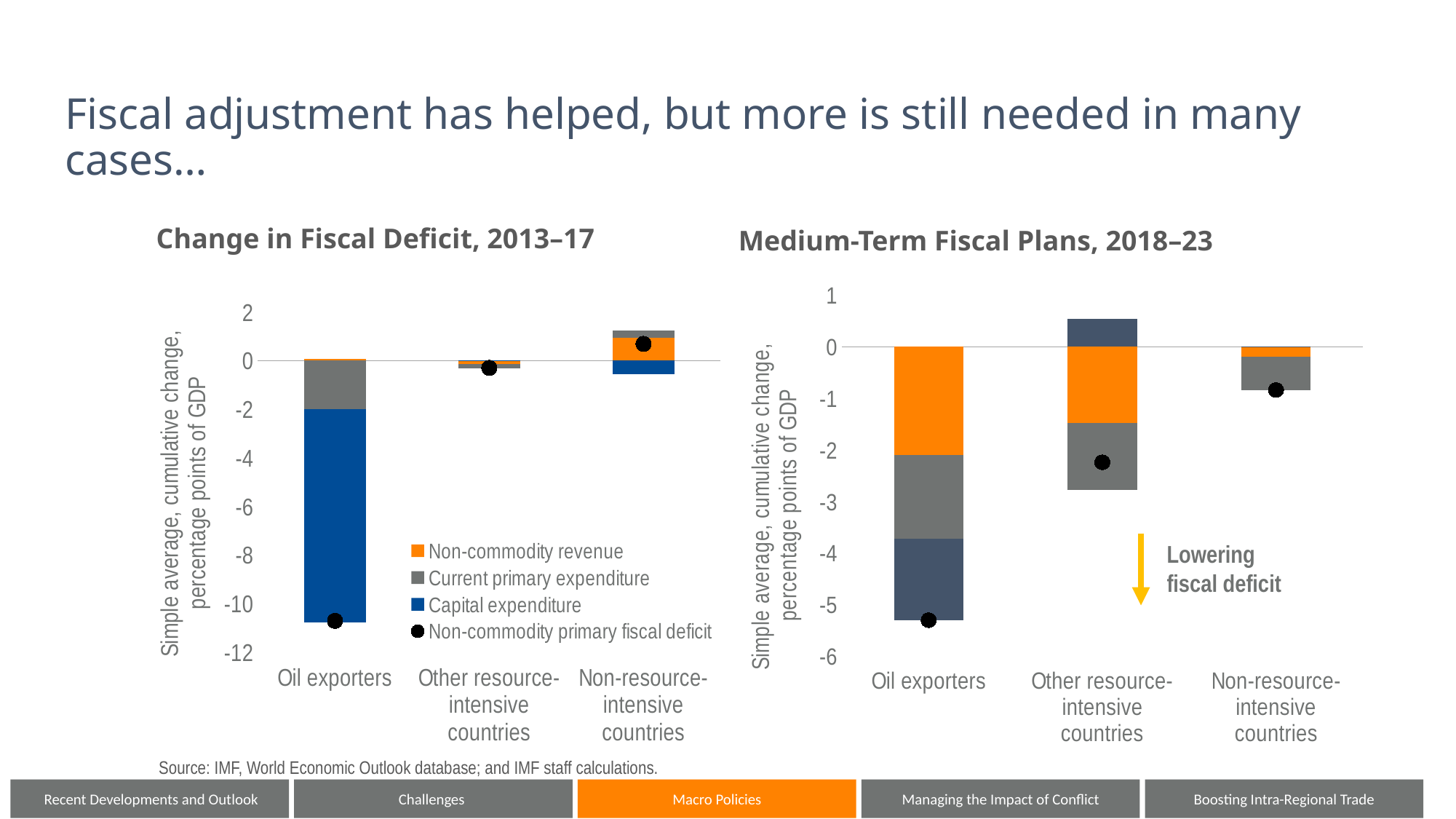
Which legend entry on the 'Change in Fiscal Deficit, 2013–17' chart is shown in orange? Non-commodity revenue In the 'Change in Fiscal Deficit, 2013–17' chart, is the non-commodity primary fiscal deficit marker for Non-resource-intensive countries greater or less than 0? greater How many entries does the legend list on the 'Change in Fiscal Deficit, 2013–17' chart? 4 In the 'Medium-Term Fiscal Plans, 2018–23' chart, is the non-commodity primary fiscal deficit marker larger for Oil exporters or for Non-resource-intensive countries? Non-resource-intensive countries In the 'Change in Fiscal Deficit, 2013–17' chart, which country group has the highest non-commodity primary fiscal deficit marker? Non-resource-intensive countries In the 'Medium-Term Fiscal Plans, 2018–23' chart, is the non-commodity primary fiscal deficit marker for Other resource-intensive countries greater or less than -2? less How many country groups are shown on the x axis of the 'Medium-Term Fiscal Plans, 2018–23' chart? 3 In the 'Change in Fiscal Deficit, 2013–17' chart, is the non-commodity primary fiscal deficit marker for Oil exporters greater or less than -10? less In the 'Medium-Term Fiscal Plans, 2018–23' chart, which country group has the lowest non-commodity primary fiscal deficit marker? Oil exporters In the 'Change in Fiscal Deficit, 2013–17' chart, which country group has the lowest non-commodity primary fiscal deficit marker? Oil exporters What kind of chart is the 'Change in Fiscal Deficit, 2013–17' chart? Stacked bar chart with markers